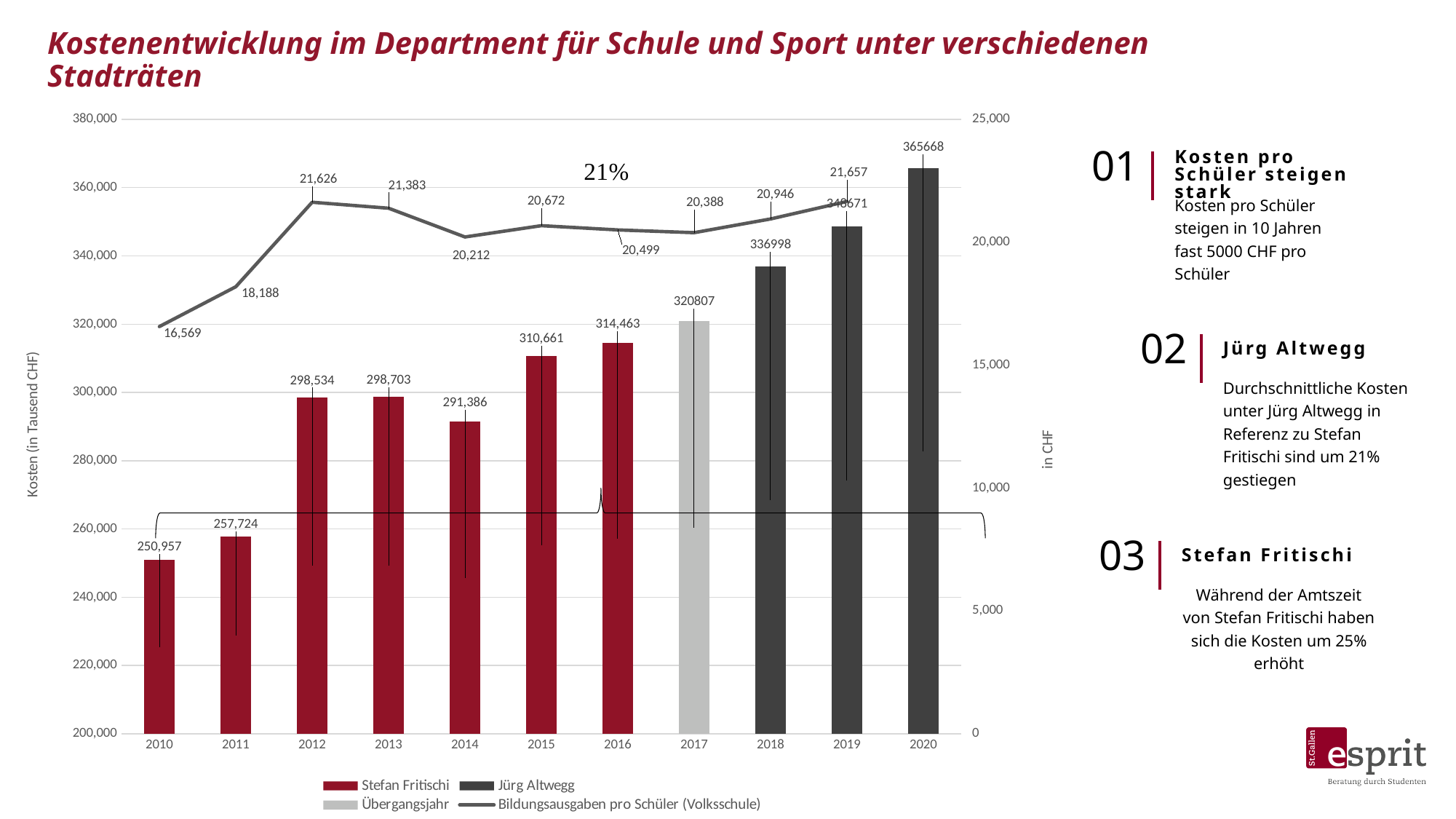
How many entries does the legend list? 4 What is the value of the Übergangsjahr bar for 2017? 320807 How many years are shown on the x axis? 11 What is the difference between the bar values for 2016 and 2010? 63,506 What is the value of the Stefan Fritischi bar for 2010? 250,957 What is the Bildungsausgaben pro Schüler value for 2012? 21,626 What kind of chart is shown on the slide? Combined bar and line chart What is the value of the Jürg Altwegg bar for 2020? 365668 Which year has the lowest Bildungsausgaben pro Schüler value? 2010 Which year has the highest bar value? 2020 Which bar is larger, 2015 or 2014? 2015 Is the bar value for 2017 greater or less than 300,000? greater